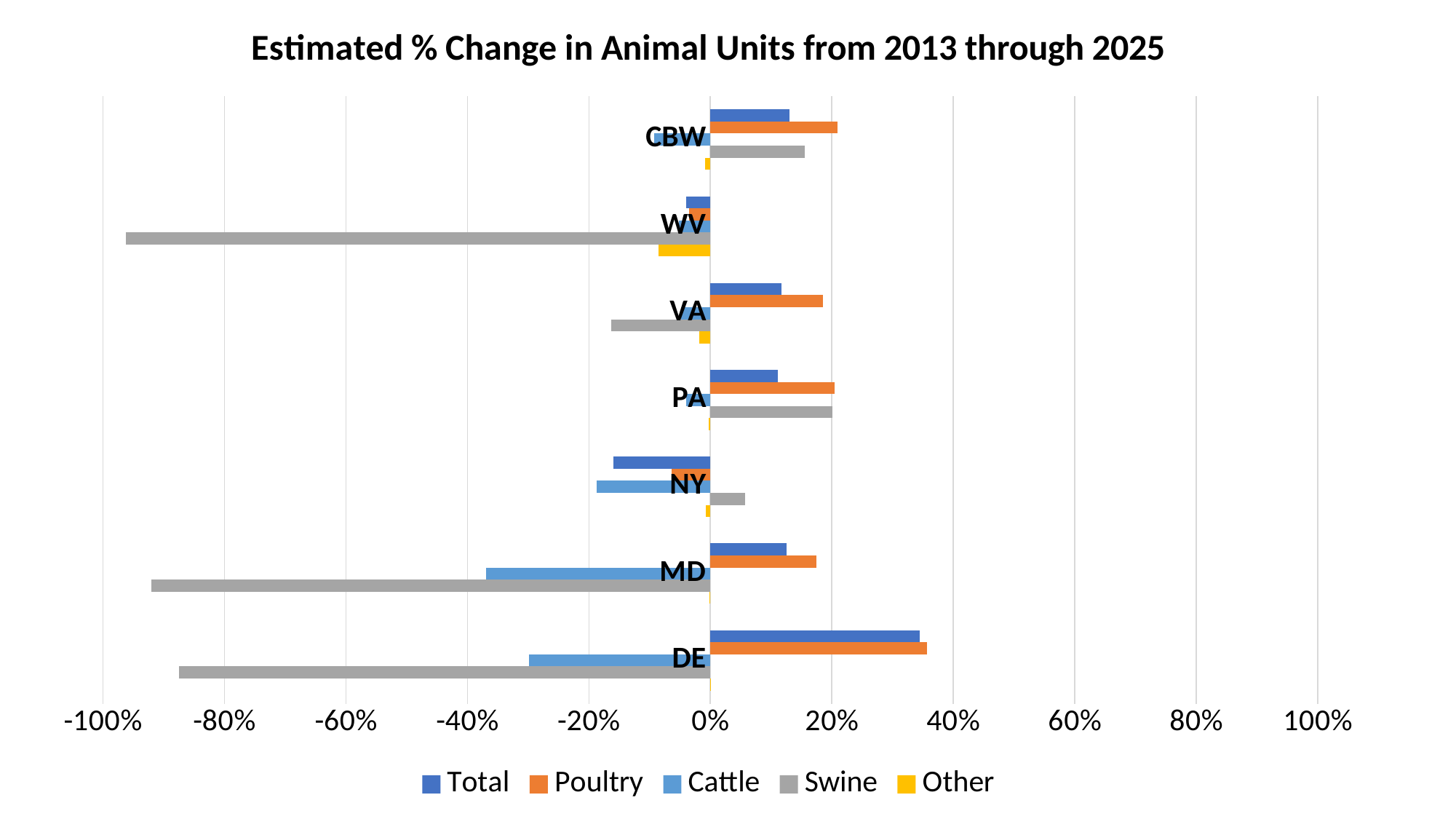
What kind of chart is shown on the slide? bar chart Is the Poultry value for DE greater or less than 20%? greater Which category has the highest Poultry value? DE What is the title of the chart? Estimated % Change in Animal Units from 2013 through 2025 How many series does the legend list? 5 How many categories (regions/states) are shown on the chart? 7 Which category has the highest Total value? DE Is the Swine value for WV greater or less than -80%? less Is the Cattle value for MD greater or less than -20%? less Which category has the lowest Cattle value? MD Which is larger, the Poultry value for DE or the Poultry value for MD? DE Which is larger, the Swine value for PA or the Swine value for NY? PA